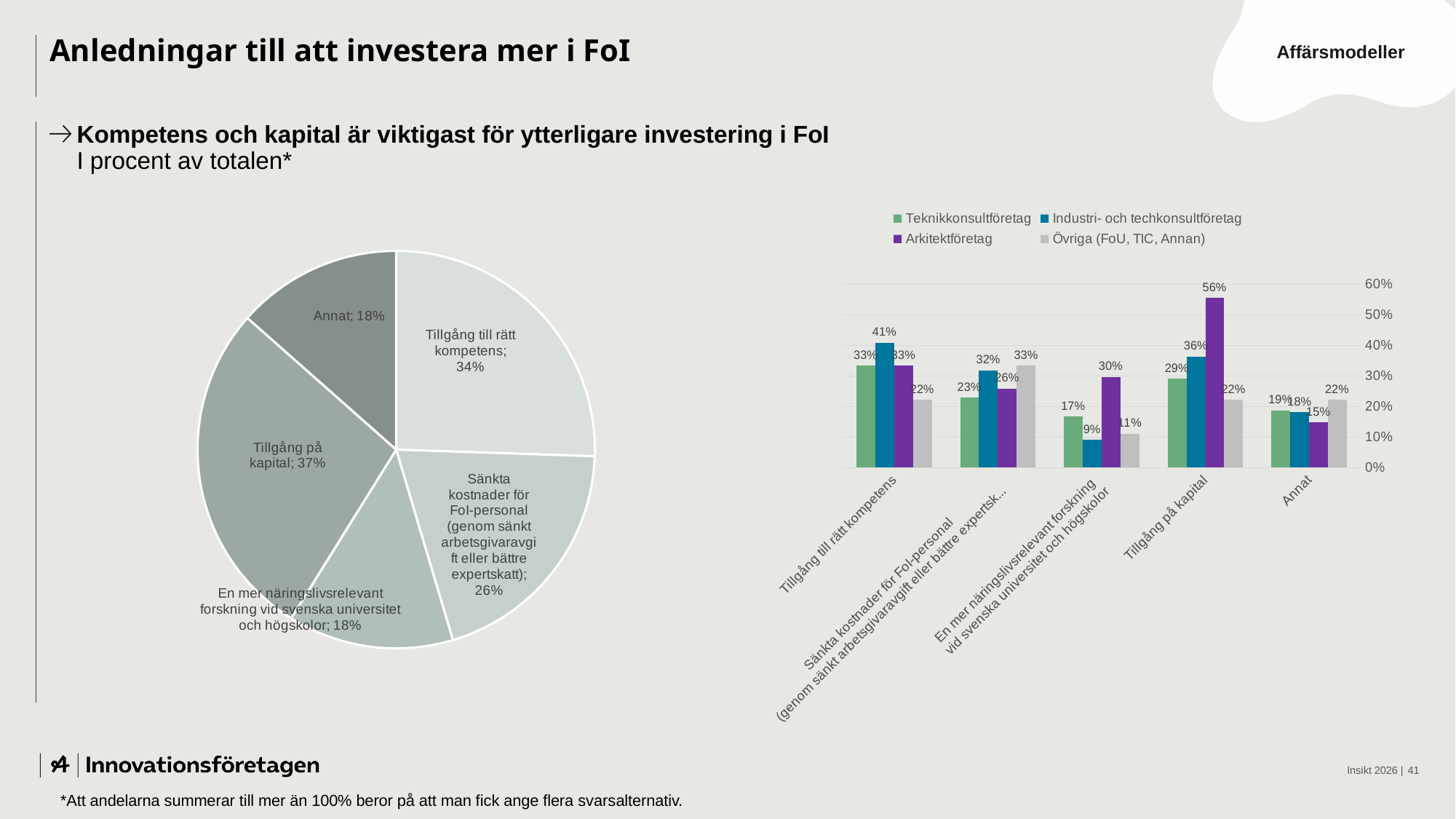
In the bar chart on the right, what is the value for Arkitektföretag for "Tillgång på kapital"? 56% What type of chart is on the right side of the slide? Bar chart How many series does the legend of the bar chart on the right list? 4 In the bar chart on the right, what is the difference between Arkitektföretag and Teknikkonsultföretag for "Tillgång på kapital"? 27 percentage points In the pie chart on the left, what share is shown for "Tillgång på kapital"? 37% In the bar chart on the right, what is the value for Industri- och techkonsultföretag for "Tillgång till rätt kompetens"? 41% In the pie chart on the left, which category has the largest slice? Tillgång på kapital In the bar chart on the right, which colour represents Arkitektföretag? Purple In the pie chart on the left, what is the difference between the shares for "Tillgång på kapital" and "Tillgång till rätt kompetens"? 3 percentage points In the bar chart on the right, which is larger for "Annat": Teknikkonsultföretag or Arkitektföretag? Teknikkonsultföretag How many slices does the pie chart on the left have? 5 In the bar chart on the right, which series has the lowest value for "En mer näringslivsrelevant forskning vid svenska universitet och högskolor"? Industri- och techkonsultföretag